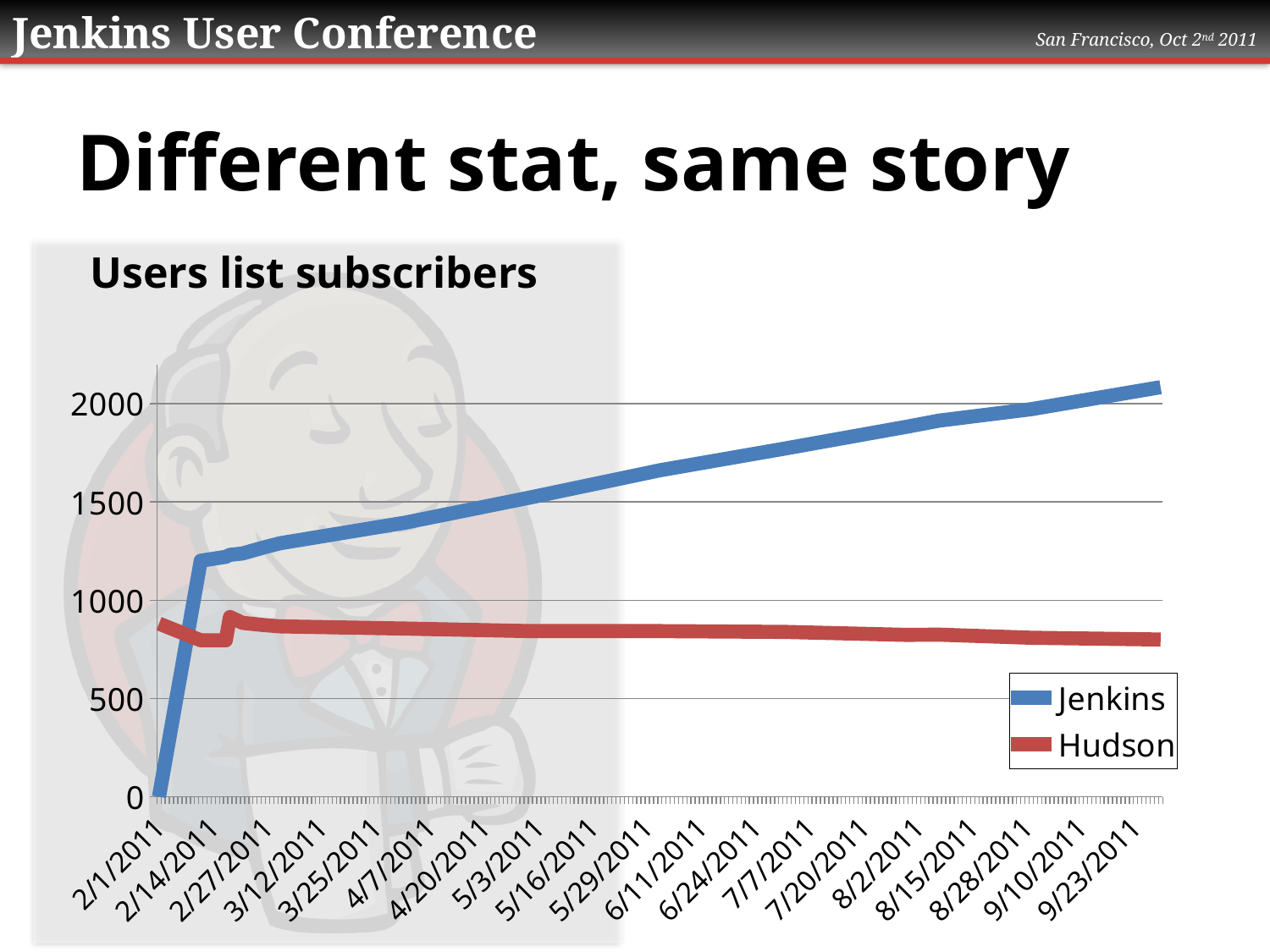
Does the Jenkins series rise or fall from 2/1/2011 to 9/23/2011? rise How many series does the legend list? 2 What is the title of the chart? Users list subscribers Is the Jenkins value at 9/23/2011 greater or less than 2000? greater How many date labels are shown along the x axis? 19 Is the Jenkins value at 7/7/2011 greater or less than 1500? greater At 2/1/2011, which series has the higher value, Jenkins or Hudson? Hudson Does the Hudson series rise or fall from 2/27/2011 to 9/23/2011? fall What kind of chart is shown on the slide? line chart Which series is drawn in blue? Jenkins At 9/23/2011, which series has the higher value, Jenkins or Hudson? Jenkins Is the Hudson value at 9/23/2011 greater or less than 1000? less